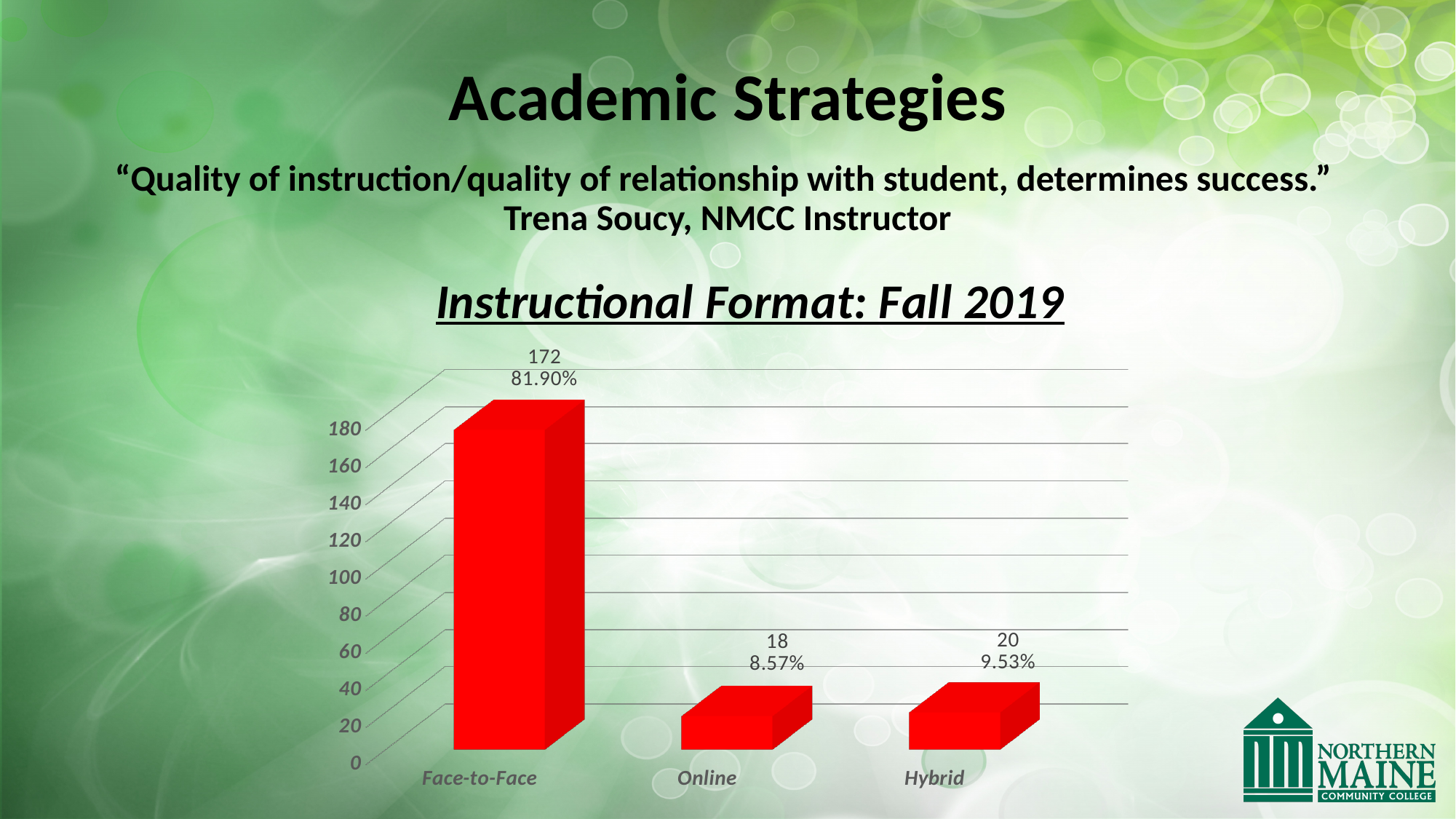
What is the title of the chart? Instructional Format: Fall 2019 What is the value for Face-to-Face? 172 What kind of chart is shown on the slide? Bar chart What is the value for Online? 18 What is the value for Hybrid? 20 How many instructional formats are shown in the chart? 3 Which is larger, the value for Online or the value for Hybrid? Hybrid What percentage is shown for Face-to-Face? 81.90% Which instructional format has the highest value? Face-to-Face What percentage is shown for Hybrid? 9.53% What is the difference between the Face-to-Face and Hybrid values? 152 Which instructional format has the lowest value? Online